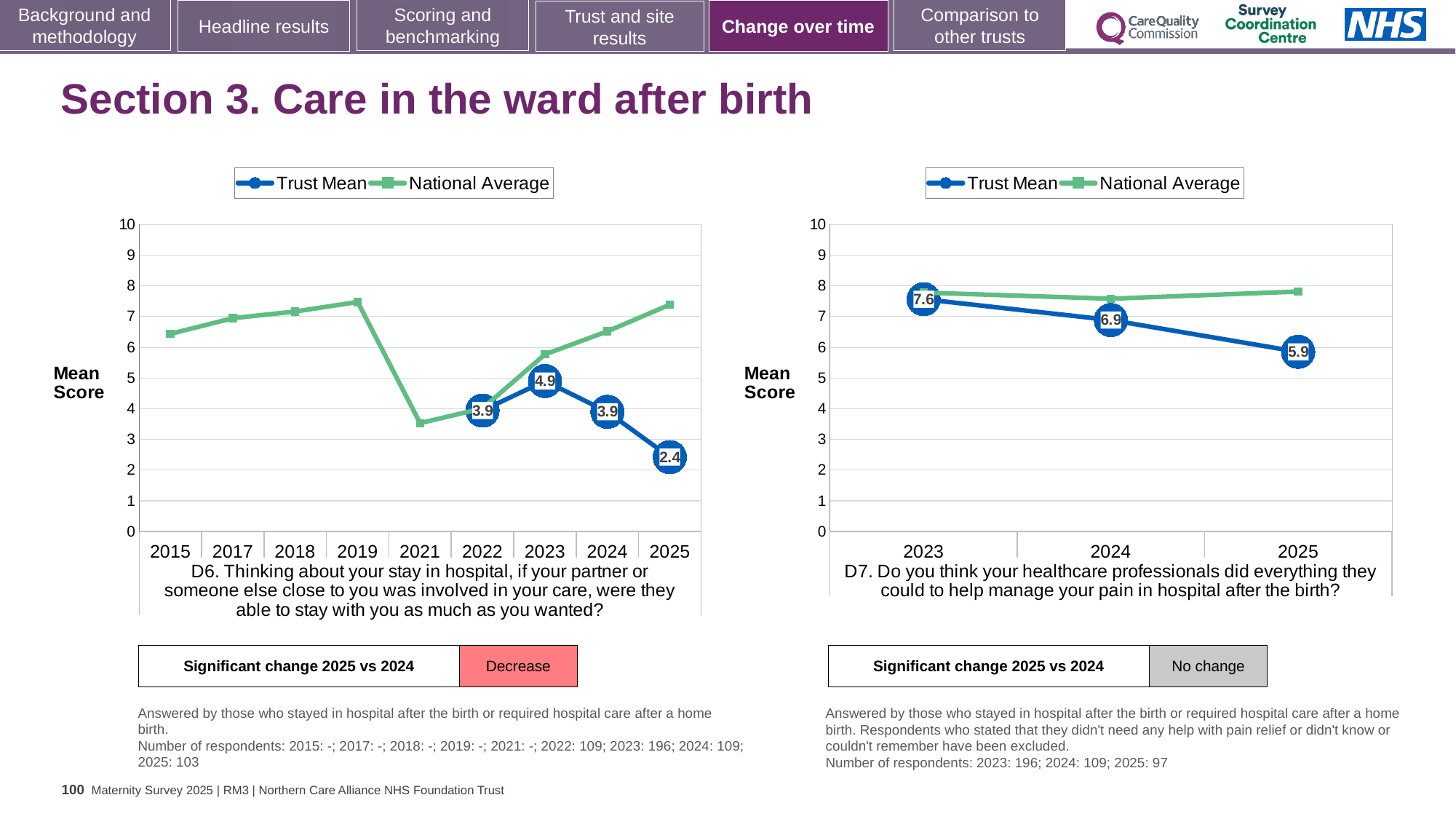
On the D7 chart (right), does the Trust Mean rise or fall from 2023 to 2025? fall On the D6 chart (left), how many years are shown on the x axis? 9 On the D7 chart (right), in which year is the Trust Mean lowest? 2025 On the D7 chart (right), what is the Trust Mean for 2024? 6.9 On the D7 chart (right), what is the difference between the Trust Mean for 2023 and 2025? 1.7 On the D6 chart (left), in which year is the labelled Trust Mean highest? 2023 What kind of chart is the D7 chart (right)? line chart On the D7 chart (right), how many series does the legend list? 2 On the D6 chart (left), what is the Trust Mean for 2025? 2.4 On the D6 chart (left), what is the difference between the Trust Mean for 2023 and 2025? 2.5 On the D6 chart (left), what is the Trust Mean for 2023? 4.9 On the D6 chart (left), is the National Average for 2019 greater or less than 7? greater